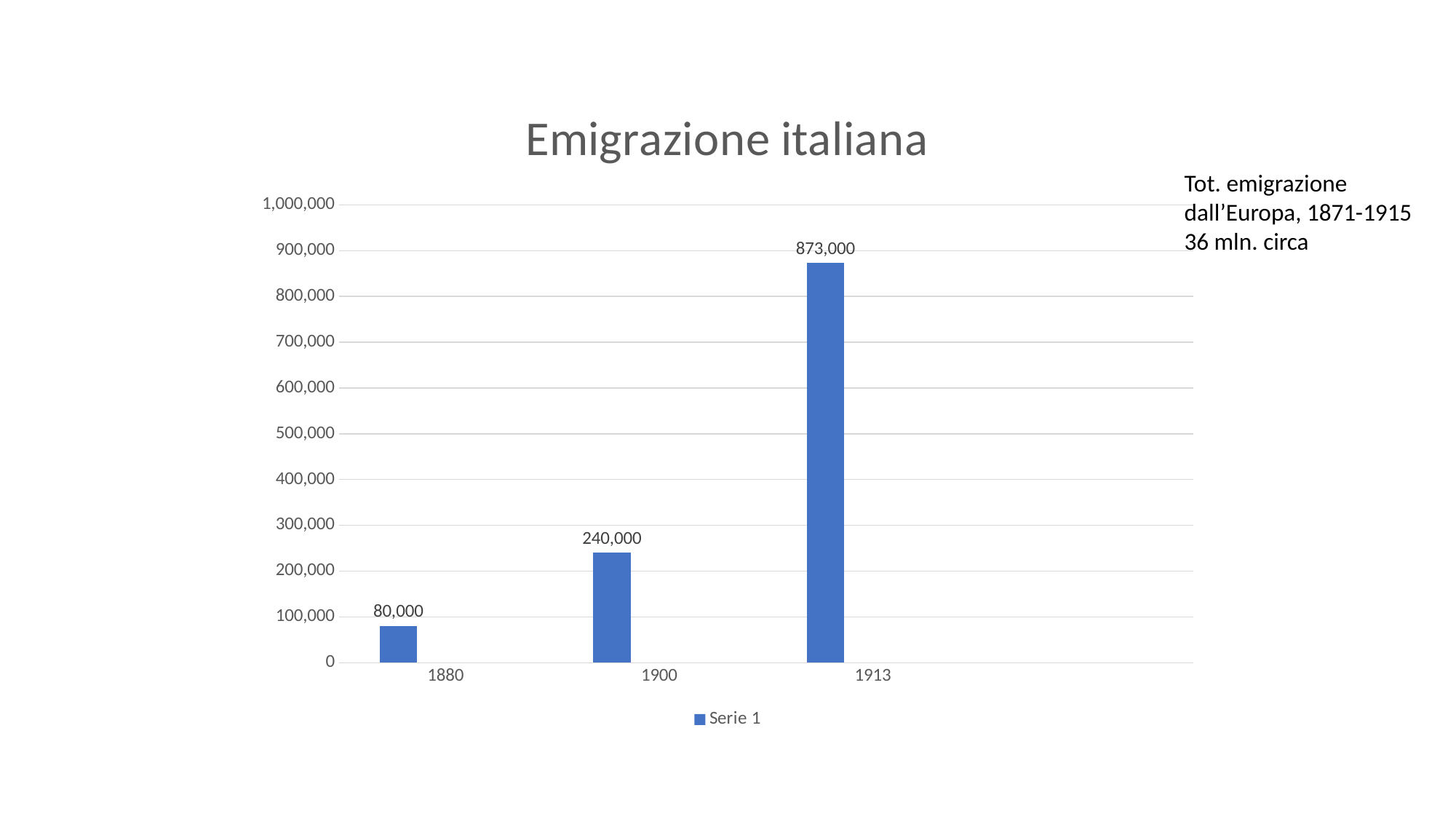
Which year has the highest value? 1913 What is the value for 1900? 240,000 What is the difference between the values for 1900 and 1880? 160,000 Which is larger, the value for 1900 or the value for 1880? 1900 Do the values rise or fall from 1880 to 1913? rise How many years are shown on the x axis? 3 Is the value for 1913 greater or less than 800,000? greater Which year has the lowest value? 1880 What is the value for 1880? 80,000 What is the difference between the values for 1913 and 1900? 633,000 What is the value for 1913? 873,000 What kind of chart is shown? bar chart